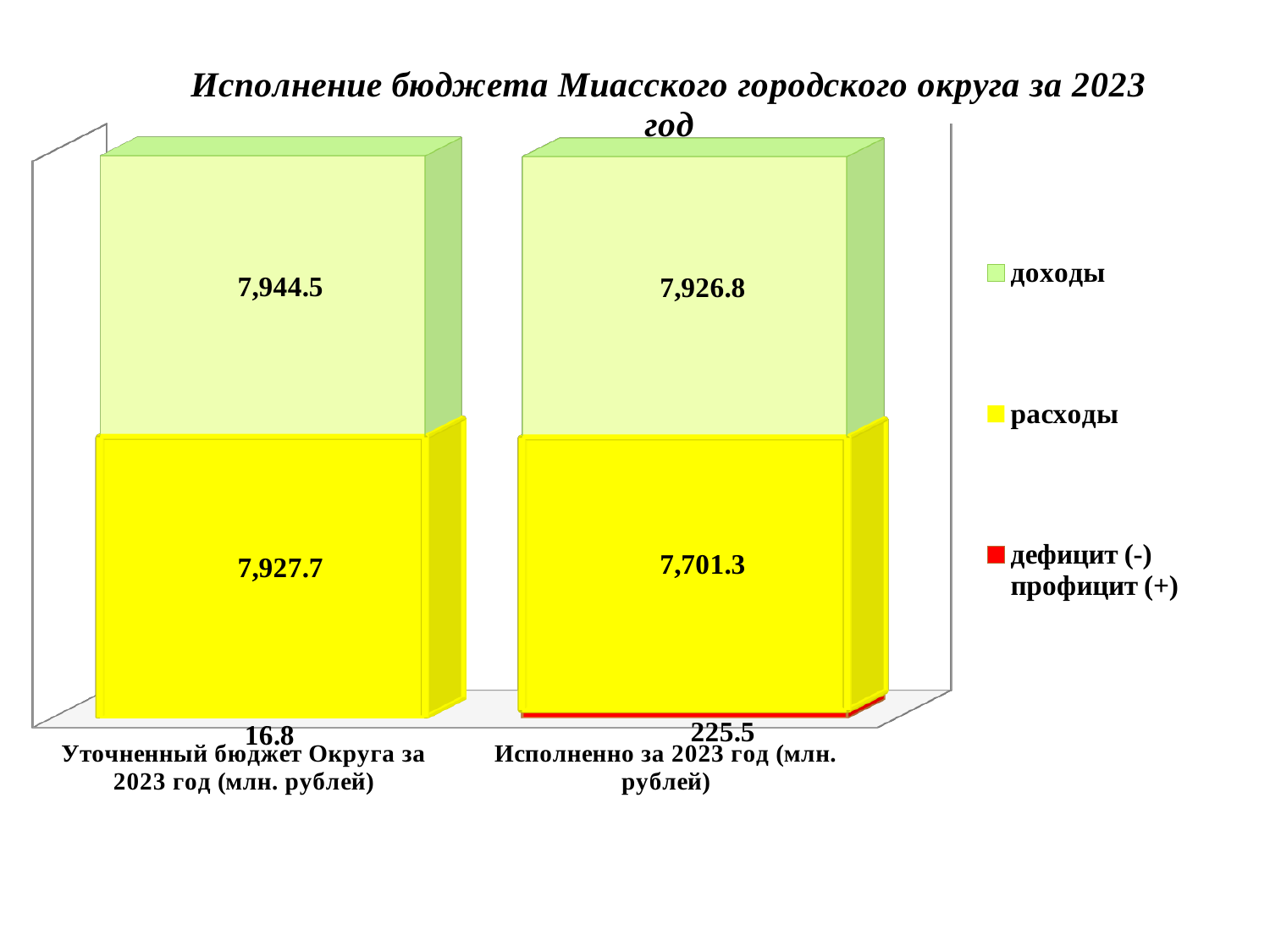
What is the value of доходы for Уточненный бюджет Округа за 2023 год? 7,944.5 How many series does the legend list? 3 What is the difference between the дефицит (-) профицит (+) values for Исполненно за 2023 год and Уточненный бюджет Округа за 2023 год? 208.7 What is the value of дефицит (-) профицит (+) for Уточненный бюджет Округа за 2023 год? 16.8 What is the difference between расходы for Уточненный бюджет Округа за 2023 год and расходы for Исполненно за 2023 год? 226.4 What is the value of расходы for Исполненно за 2023 год? 7,701.3 Which category has the higher дефицит (-) профицит (+) value? Исполненно за 2023 год (млн. рублей) How many categories are shown on the x axis? 2 What is the value of дефицит (-) профицит (+) for Исполненно за 2023 год? 225.5 Which category has the higher расходы value? Уточненный бюджет Округа за 2023 год (млн. рублей) What is the difference between доходы for Уточненный бюджет Округа за 2023 год and доходы for Исполненно за 2023 год? 17.7 What kind of chart is shown on the slide? Stacked bar chart